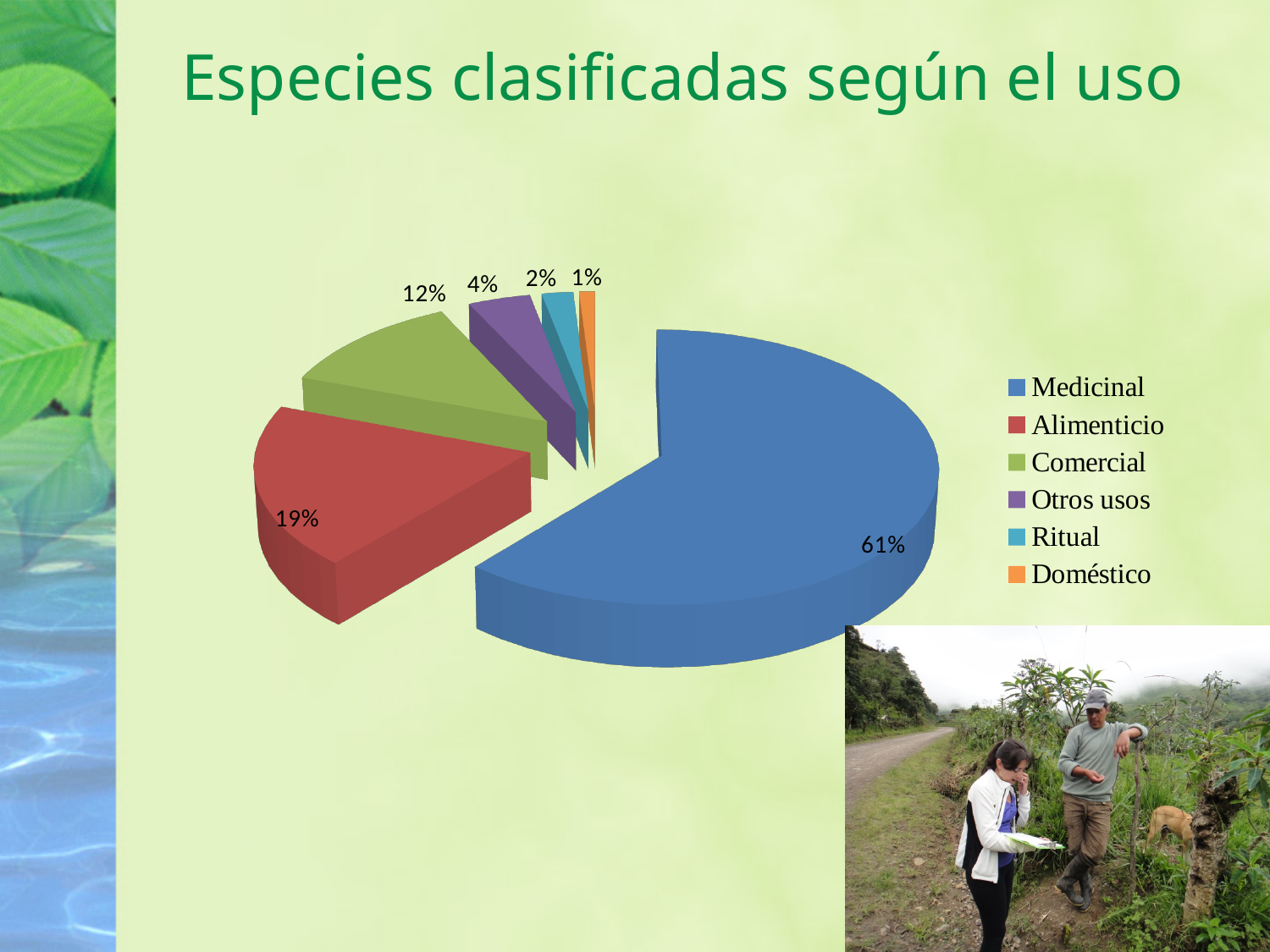
What is the value shown for Comercial? 12% What is the difference in percentage points between Medicinal and Alimenticio? 42 Which category has the largest slice of the pie? Medicinal Which category has the smallest slice of the pie? Doméstico What kind of chart is shown on the slide? Pie chart What is the value shown for Ritual? 2% How many categories does the legend list? 6 What is the value shown for Alimenticio? 19% What is the title of the chart? Especies clasificadas según el uso Which is larger, Comercial or Otros usos? Comercial What is the value shown for Otros usos? 4% What share of the pie does Medicinal represent? 61%